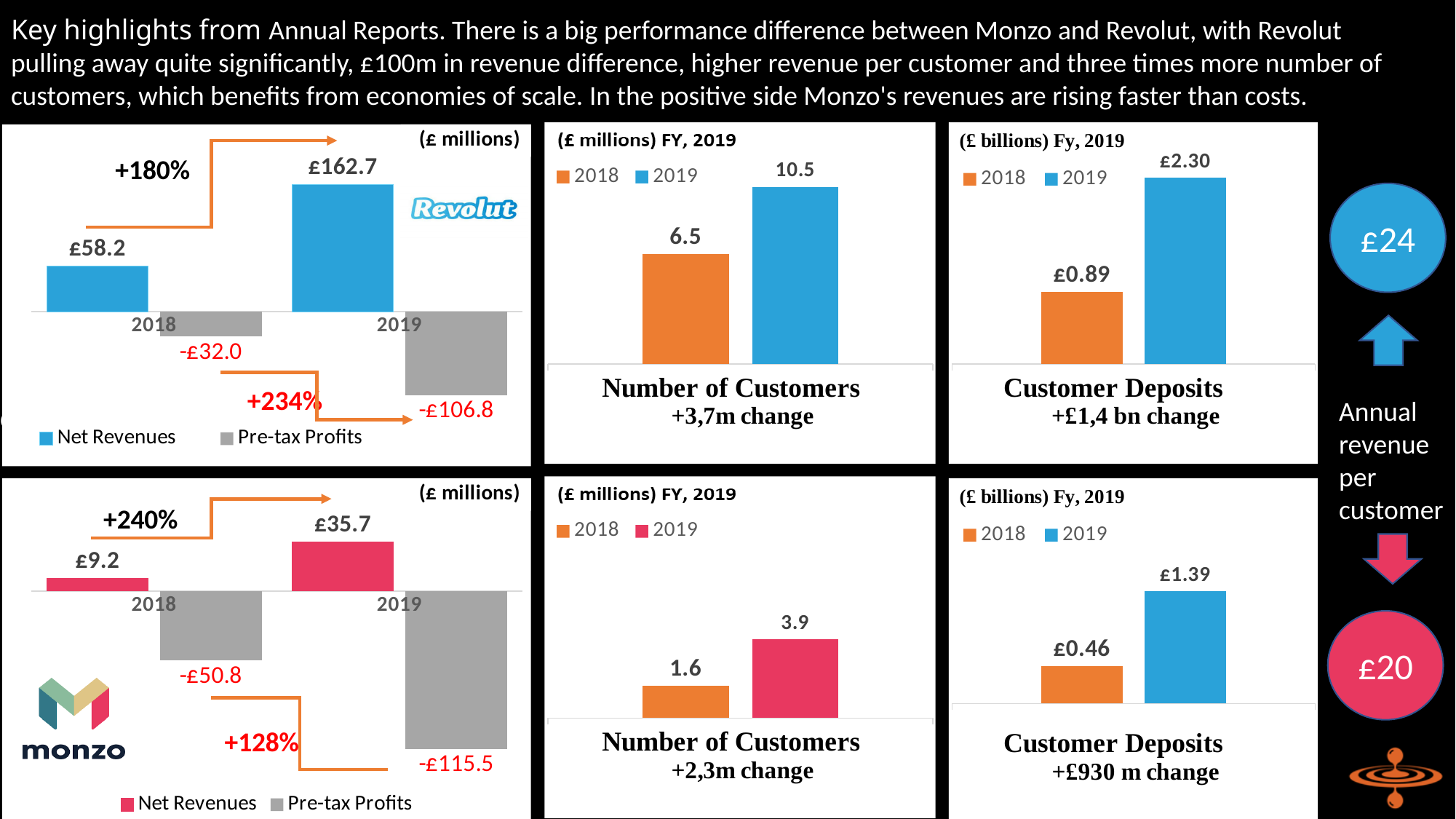
How many series does the legend list in the top-left Revolut net revenues and pre-tax profits chart? 2 In the bottom-middle Monzo Number of Customers chart, what was the number of customers in 2018? 1.6 In the bottom-left Monzo net revenues and pre-tax profits chart, what was Monzo's pre-tax profit in 2019? -£115.5 In the top-left Revolut net revenues and pre-tax profits chart, what was Revolut's pre-tax profit in 2018? -£32.0 Which is larger: Revolut's 2019 number of customers in the top-middle chart or Monzo's 2019 number of customers in the bottom-middle chart? Revolut's (10.5) In the top-right Revolut Customer Deposits chart, what were customer deposits in 2018? £0.89 What type of chart is the top-middle Revolut Number of Customers chart? Bar chart In the bottom-right Monzo Customer Deposits chart, what is the difference between 2019 and 2018 deposits? £0.93 In the bottom-left Monzo net revenues and pre-tax profits chart, by how much did net revenues increase from 2018 to 2019? £26.5 In the bottom-right Monzo Customer Deposits chart, what were customer deposits in 2019? £1.39 In the top-left Revolut net revenues and pre-tax profits chart, what were Revolut's net revenues in 2019? £162.7 In the top-middle Revolut Number of Customers chart, what was the number of customers in 2019? 10.5